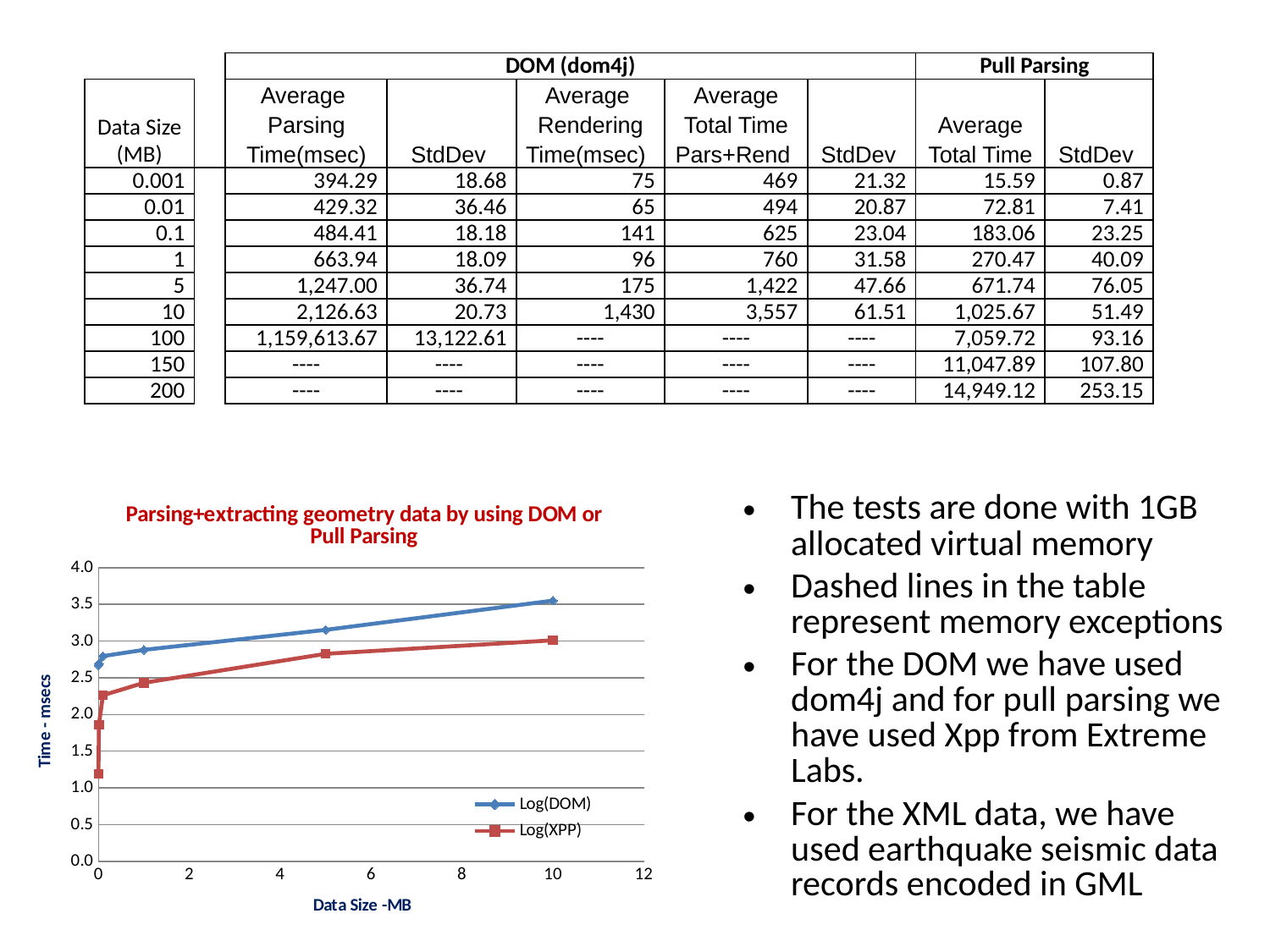
Is the Log(DOM) value at a data size of 10 MB greater or less than 3.0? greater How many series does the chart legend list? 2 What are the two series named in the chart legend? Log(DOM) and Log(XPP) What is the title of the chart? Parsing+extracting geometry data by using DOM or Pull Parsing What kind of chart is shown on the slide? line chart Do the Log(DOM) values rise or fall as Data Size increases along the x axis? rise Is the Log(DOM) value at a data size of 1 MB greater or less than 2.5? greater Which series lies above the other across the whole chart, Log(DOM) or Log(XPP)? Log(DOM) At a data size of 10 MB, which series has the larger value, Log(DOM) or Log(XPP)? Log(DOM) Is the Log(XPP) value at a data size of 5 MB greater or less than 3.0? less Do the Log(XPP) values rise or fall as Data Size increases along the x axis? rise